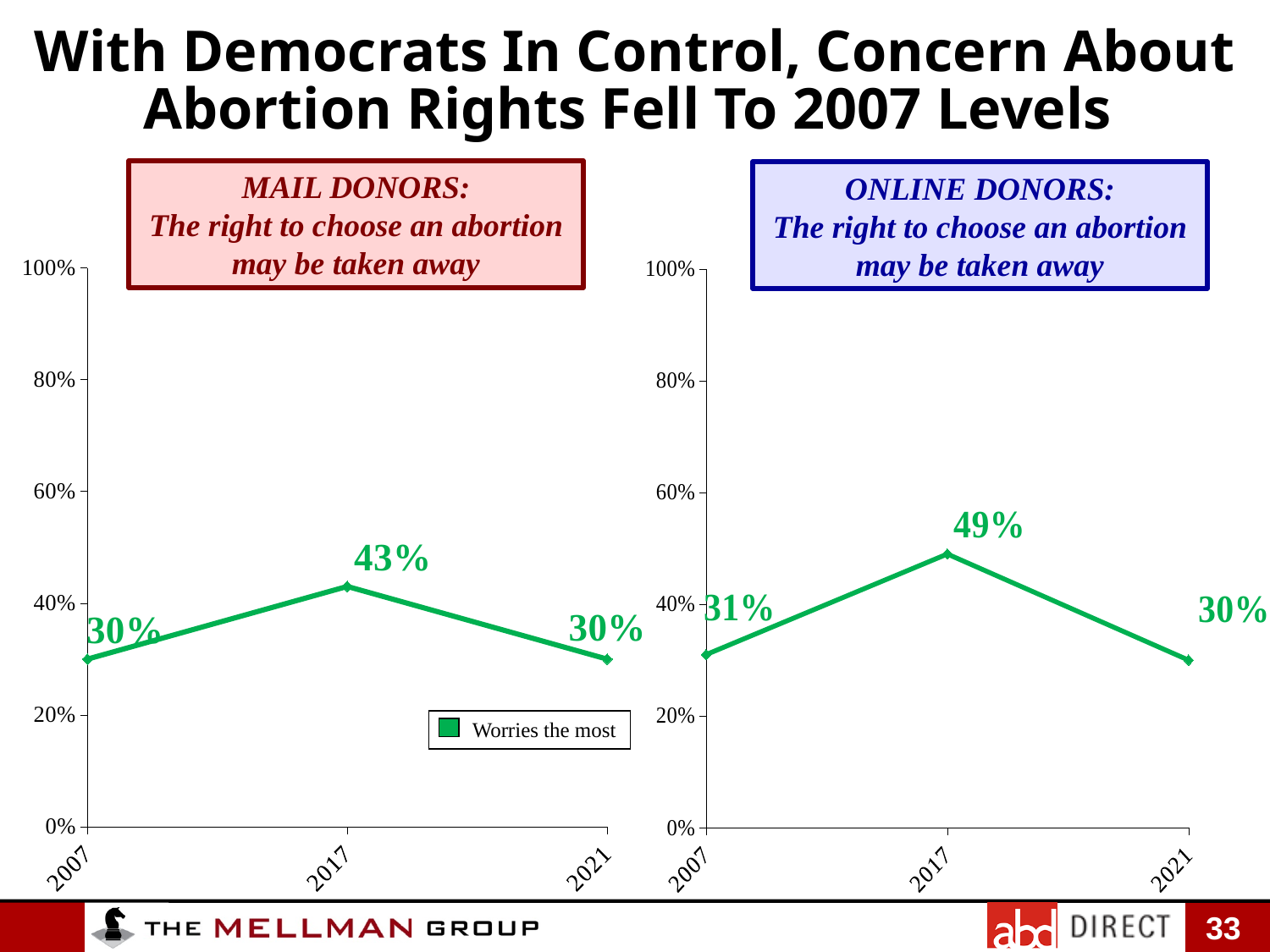
In the Mail Donors chart, what is the difference between the 2017 value and the 2007 value? 13% In the Online Donors chart, does the value rise or fall from 2017 to 2021? Fall In the Online Donors chart, what is the difference between the 2017 value and the 2021 value? 19% What series name does the legend in the Mail Donors chart show? Worries the most In the Online Donors chart, what is the value for 2021? 30% What kind of chart is the Online Donors chart? Line chart In the Mail Donors chart, what is the value for 2017? 43% Which is larger: the 2017 value in the Mail Donors chart or the 2017 value in the Online Donors chart? Online Donors In the Online Donors chart, which year has the lowest value? 2021 In the Online Donors chart, what is the value for 2007? 31% In the Mail Donors chart, which year has the highest value? 2017 How many data points are plotted in the Mail Donors chart? 3